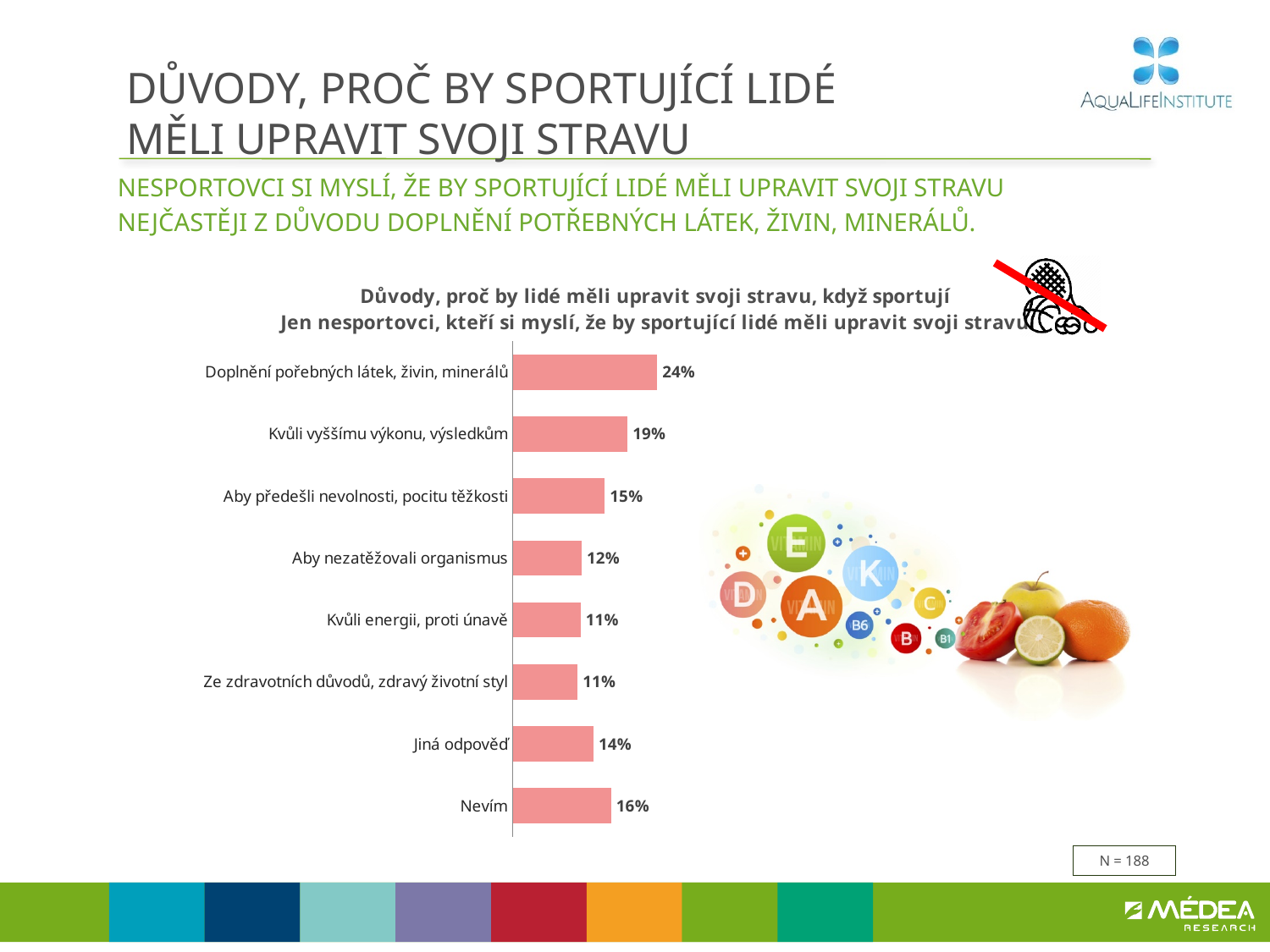
Which is larger: "Aby předešli nevolnosti, pocitu těžkosti" or "Kvůli energii, proti únavě"? Aby předešli nevolnosti, pocitu těžkosti What percentage is shown for "Doplnění pořebných látek, živin, minerálů"? 24% What is the value for "Kvůli vyššímu výkonu, výsledkům"? 19% Which category has the highest value? Doplnění pořebných látek, živin, minerálů Which is larger: "Nevím" or "Jiná odpověď"? Nevím What kind of chart is shown on the slide? Bar chart What is the difference between "Aby předešli nevolnosti, pocitu těžkosti" and "Aby nezatěžovali organismus"? 3% What percentage is shown for "Nevím"? 16% What sample size (N) is shown on the slide? N = 188 What is the difference between "Doplnění pořebných látek, živin, minerálů" and "Kvůli vyššímu výkonu, výsledkům"? 5% What is the value for "Jiná odpověď"? 14% How many categories are shown in the chart? 8